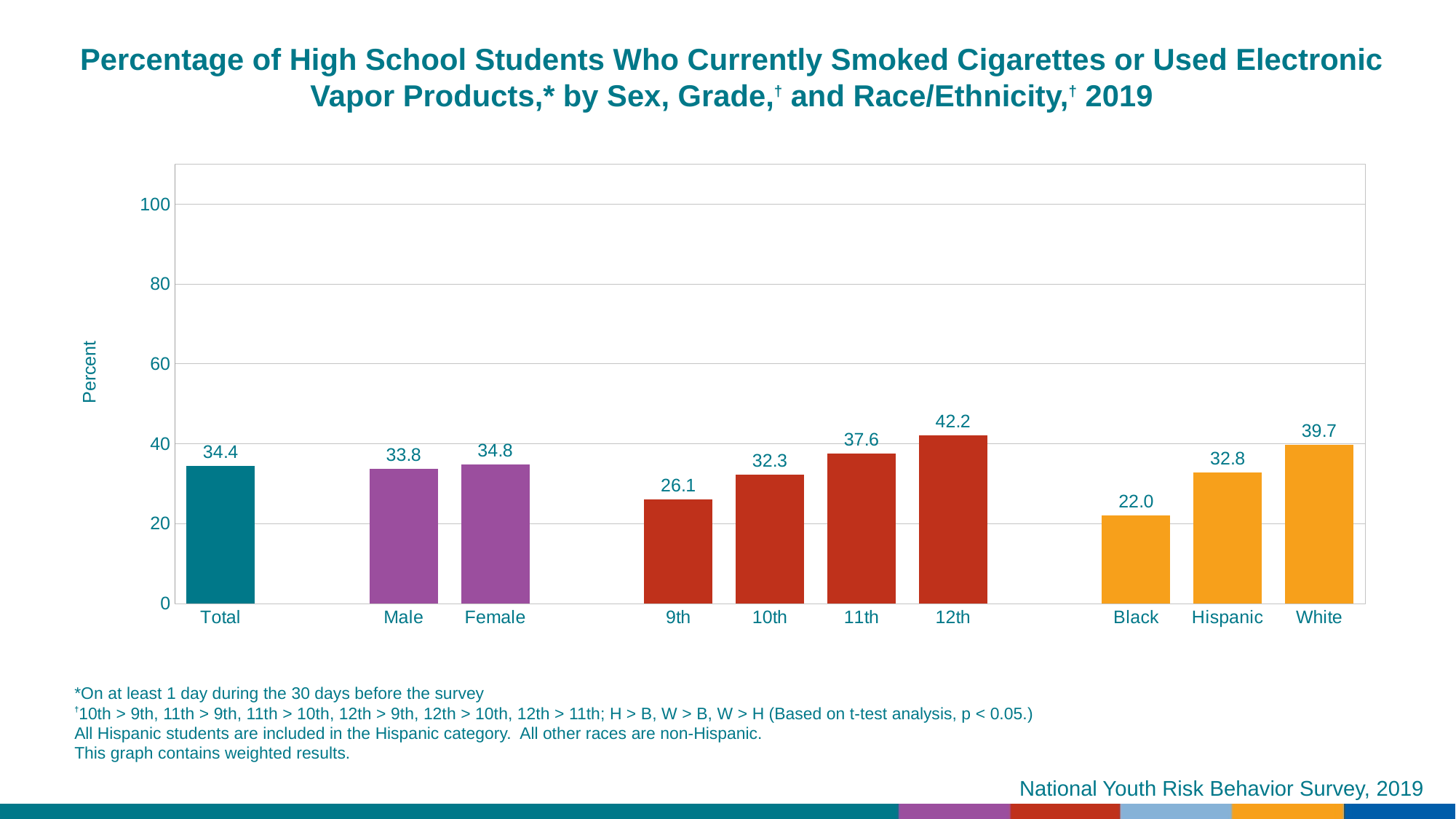
Which category has the lowest value? Black Which is larger, the value for 11th grade or the value for 10th grade? 11th What is the value for Black students? 22.0 What is the difference between the values for White and Hispanic students? 6.9 Is the value for White students greater or less than 20? greater What is the value for Total? 34.4 What is the difference between the values for 12th and 9th grade? 16.1 What kind of chart is this? bar chart How many categories are shown on the x axis? 10 What is the value for 9th grade students? 26.1 Do the values rise or fall from 9th grade to 12th grade? rise Which category has the highest value? 12th